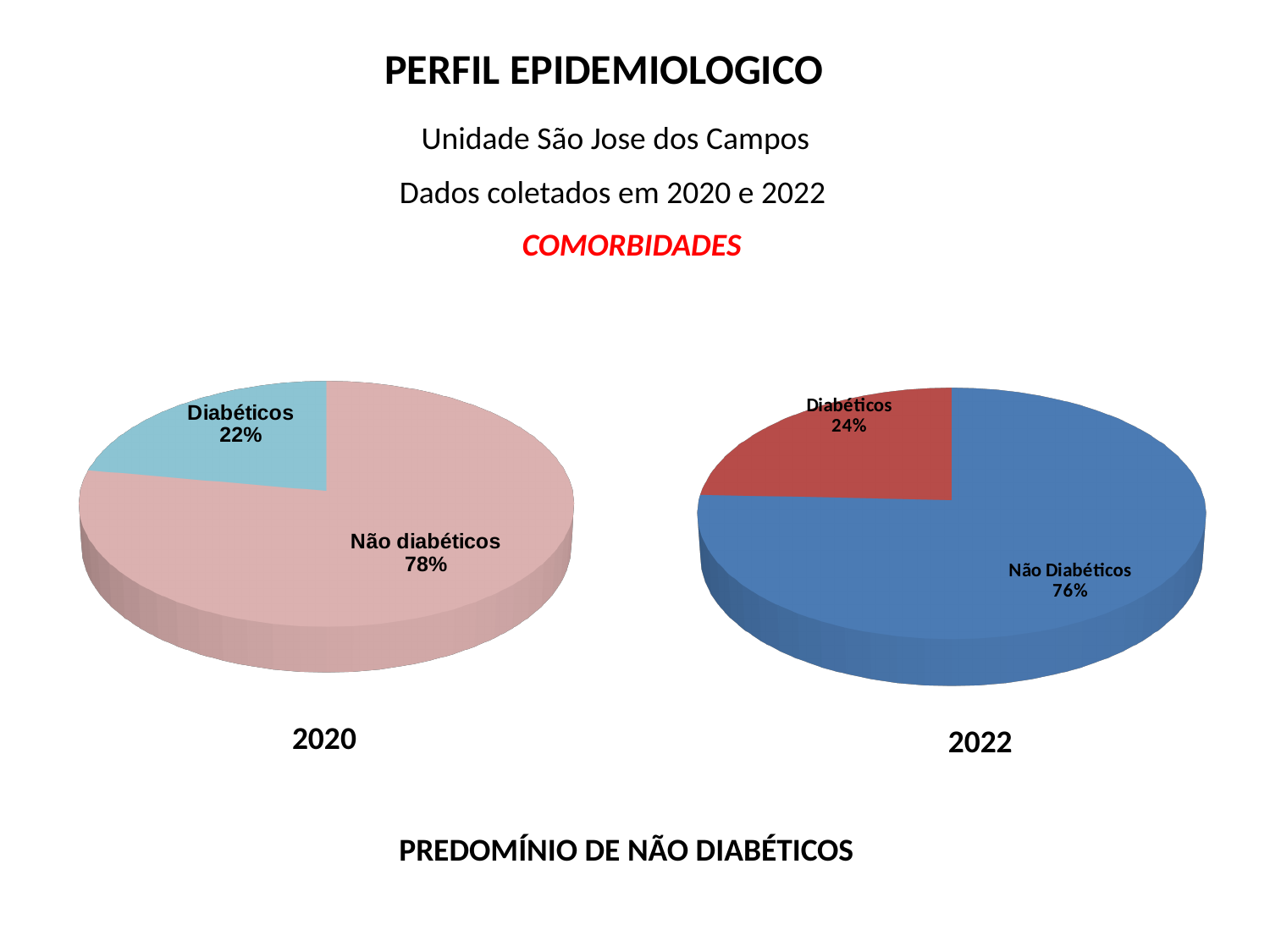
In the 2020 pie chart, what is the difference between the Não diabéticos and Diabéticos shares? 56% In the 2020 pie chart, which slice is the largest? Não diabéticos In the 2022 pie chart, what is the difference between the Não Diabéticos and Diabéticos shares? 52% What colour is the Diabéticos slice in the 2022 pie chart? Red In the 2022 pie chart, what percentage is labelled for Não Diabéticos? 76% In the 2020 pie chart, what percentage is labelled for Diabéticos? 22% In the 2020 pie chart, what percentage is labelled for Não diabéticos? 78% In the 2022 pie chart, what percentage is labelled for Diabéticos? 24% What type of chart is the 2022 chart? Pie chart In the 2022 pie chart, which slice is the smallest? Diabéticos Which is larger: the Diabéticos share in the 2020 chart or the Diabéticos share in the 2022 chart? 2022 How many slices does the 2020 pie chart have? 2